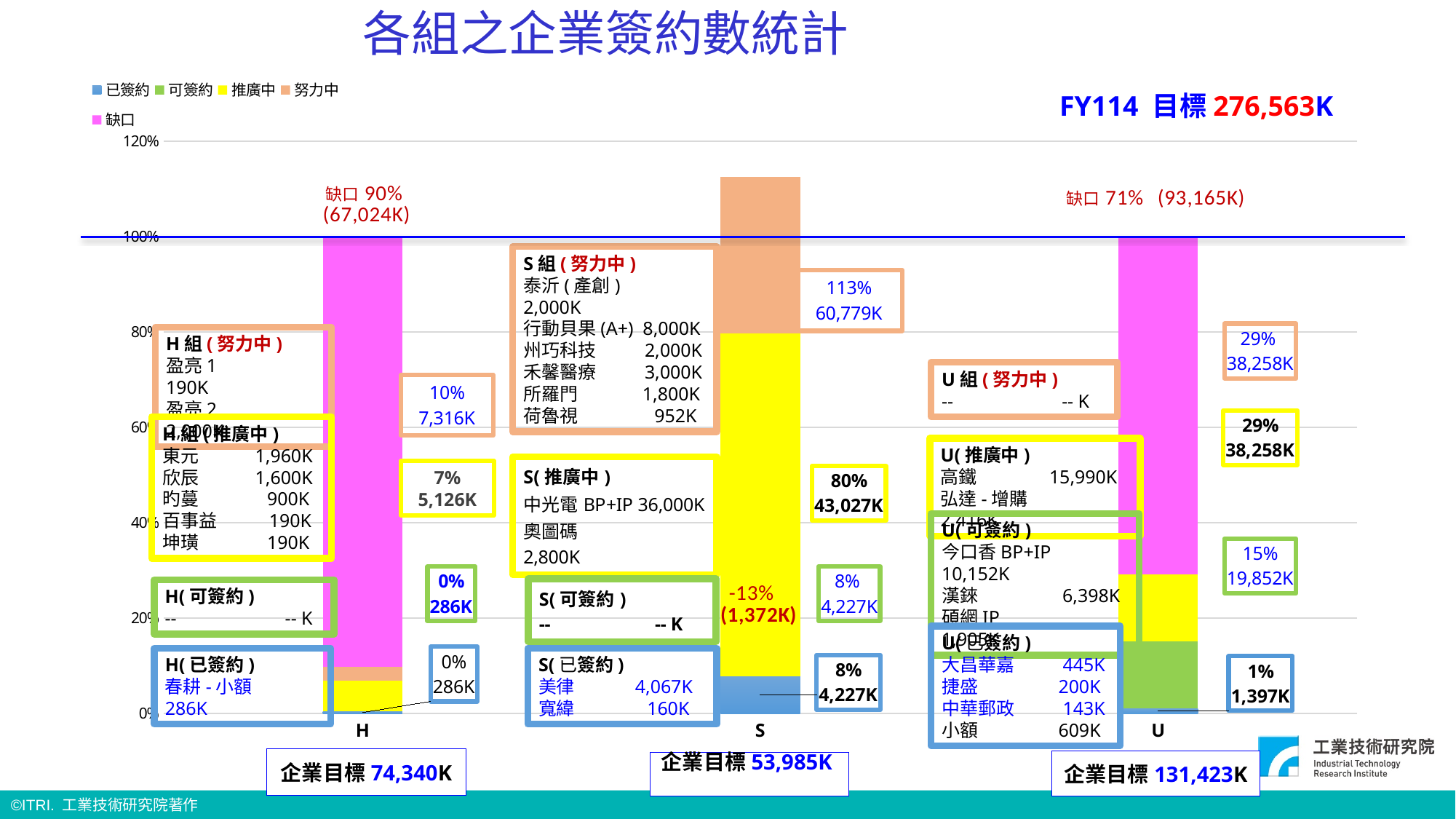
What is the 努力中 percentage labelled for group S? 113% How many groups (categories) are shown on the x axis of the chart? 3 Which group has the highest 企業目標 shown below the chart? U What kind of chart is shown on the slide? bar chart What is the 缺口 percentage labelled for group H? 90% What is the 缺口 amount labelled for group U? 93,165K What is the 推廣中 value labelled for group S? 43,027K How many series does the chart legend list? 5 What is the 已簽約 value labelled for group U? 1,397K Which group has the lowest 企業目標 shown below the chart? S Which is larger, the 可簽約 value for group U (19,852K) or for group S (4,227K)? U (19,852K) What is the FY114 目標 value shown on the slide? 276,563K